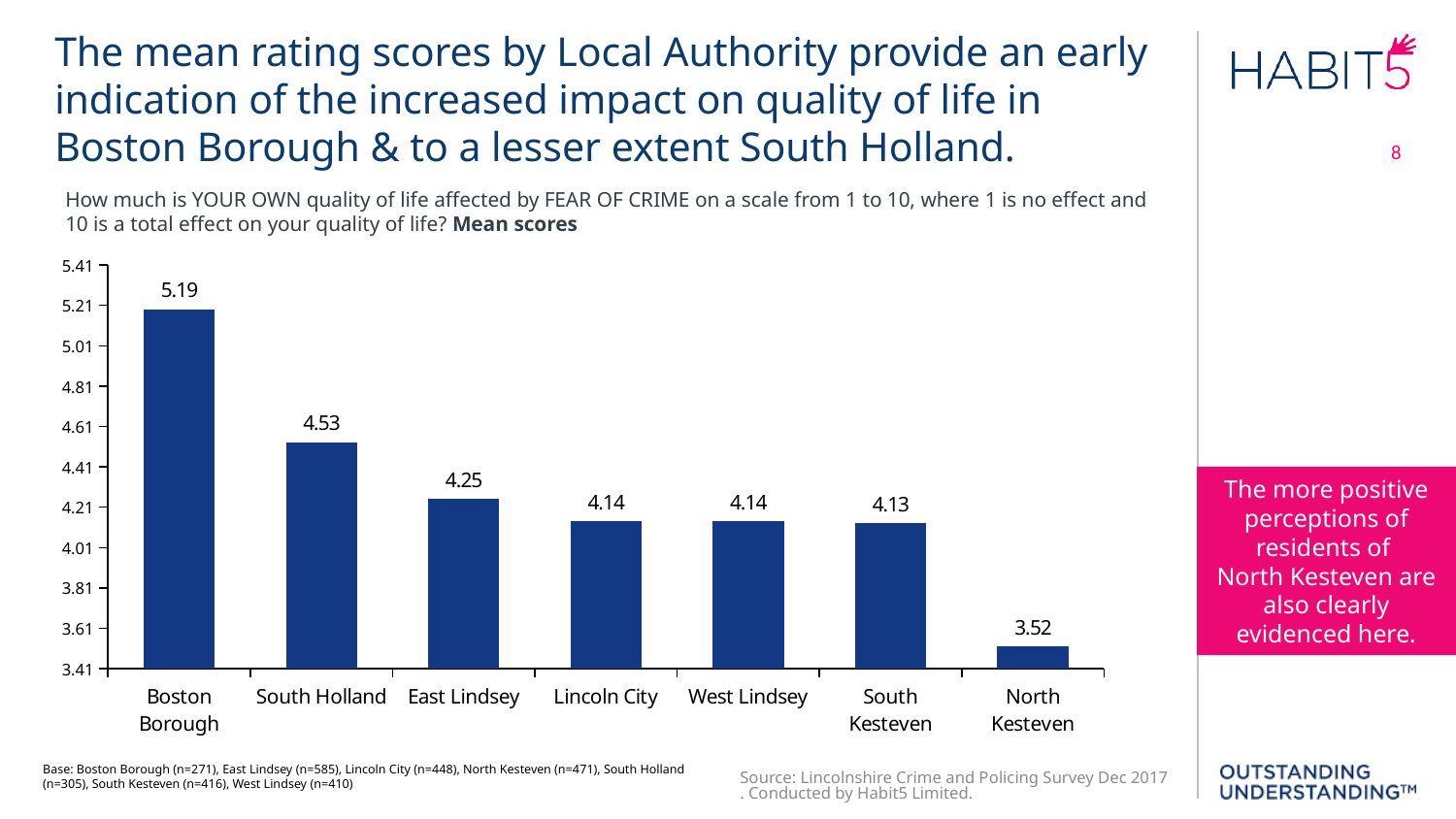
What is the mean score for Boston Borough? 5.19 Which Local Authority has the highest mean score? Boston Borough How many Local Authorities are shown in the chart? 7 What is the difference between the mean scores for Boston Borough and North Kesteven? 1.67 What is the mean score for South Holland? 4.53 What is the difference between the mean scores for South Holland and East Lindsey? 0.28 Which Local Authority has the lowest mean score? North Kesteven What is the mean score for East Lindsey? 4.25 What kind of chart is shown on the slide? Bar chart Do the mean scores rise or fall moving from left to right across the chart? Fall Which has a higher mean score, South Holland or South Kesteven? South Holland What is the mean score for North Kesteven? 3.52